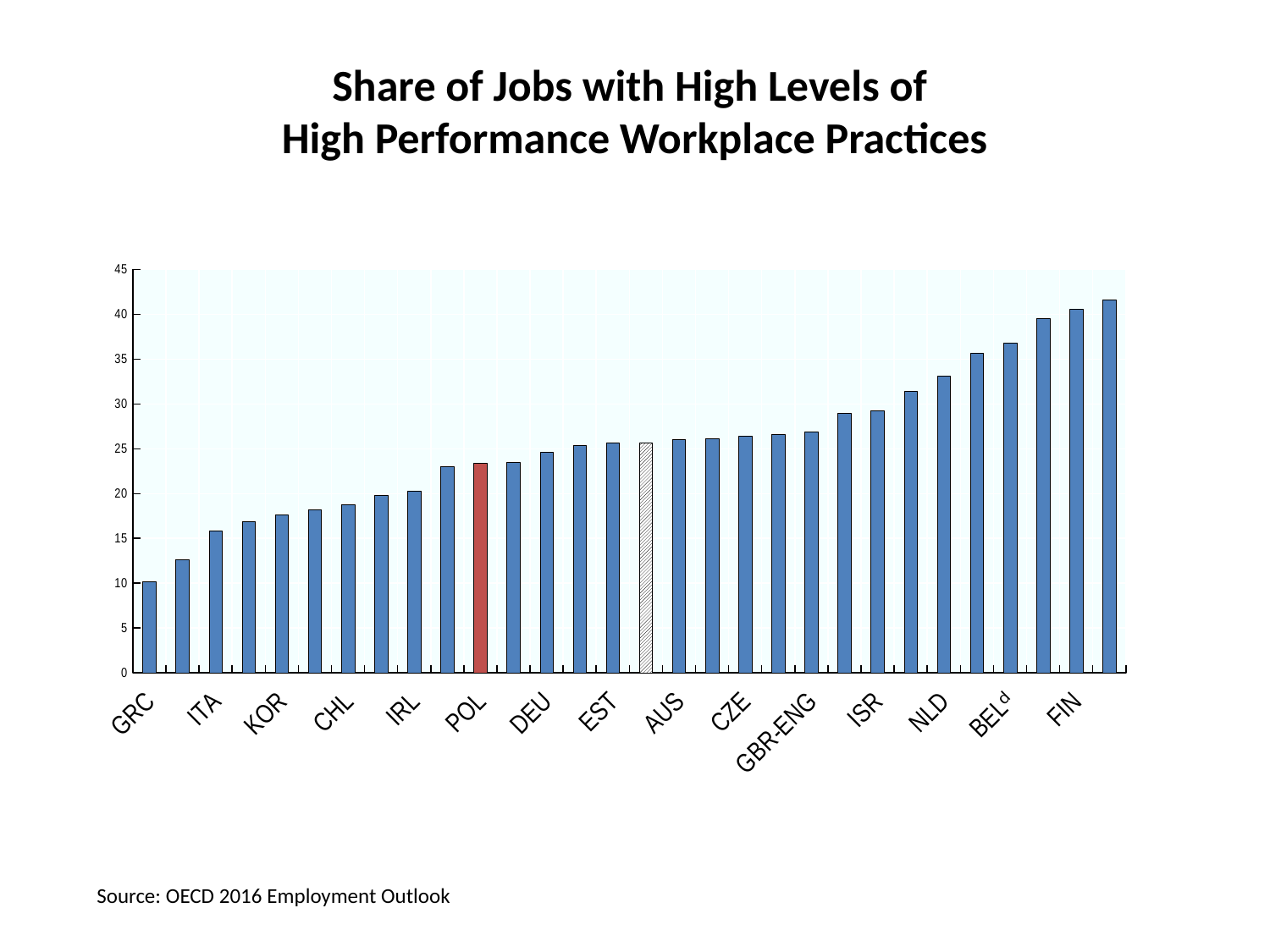
Which has a higher value, POL or NLD? NLD Which has a higher value, FIN or GRC? FIN Is the value for POL greater or less than 20? greater Which labelled country has the lowest share of jobs with high levels of high performance workplace practices? GRC Do the bar values generally rise or fall from left to right along the x axis? rise How many bars are plotted in the chart? 30 Is the value for NLD greater or less than 30? greater Which country's bar is highlighted in red? POL Is the value for KOR greater or less than 20? less What kind of chart is shown on the slide? bar chart